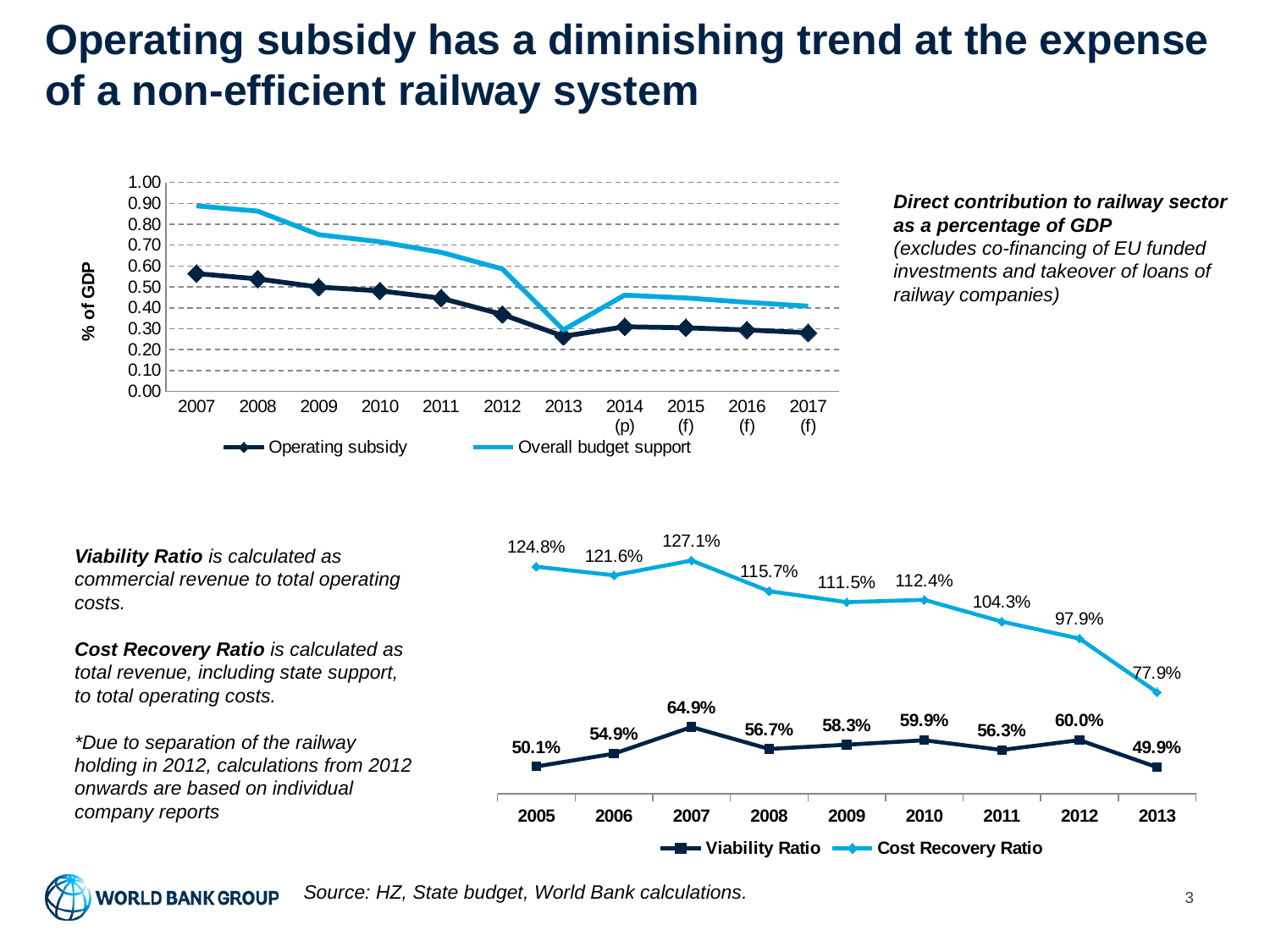
What type of chart is the top chart (% of GDP)? line chart In the bottom chart, what is the Cost Recovery Ratio for 2007? 127.1% In the bottom chart, how many years are shown on the x axis? 9 In the bottom chart, which year has the lowest Cost Recovery Ratio? 2013 In the bottom chart, what is the Viability Ratio for 2013? 49.9% In the bottom chart, which year has the highest Viability Ratio? 2007 In the bottom chart, is the Viability Ratio higher in 2010 or in 2011? 2010 In the bottom chart, how many series does the legend list? 2 In the bottom chart, what is the difference between the Cost Recovery Ratio in 2005 and in 2013? 46.9% In the top chart (% of GDP), is the value for Overall budget support in 2007 greater or less than 0.80? greater In the top chart (% of GDP), does the Overall budget support line generally rise or fall from 2007 to 2013? fall In the top chart (% of GDP), is the value for Operating subsidy in 2013 greater or less than 0.30? less